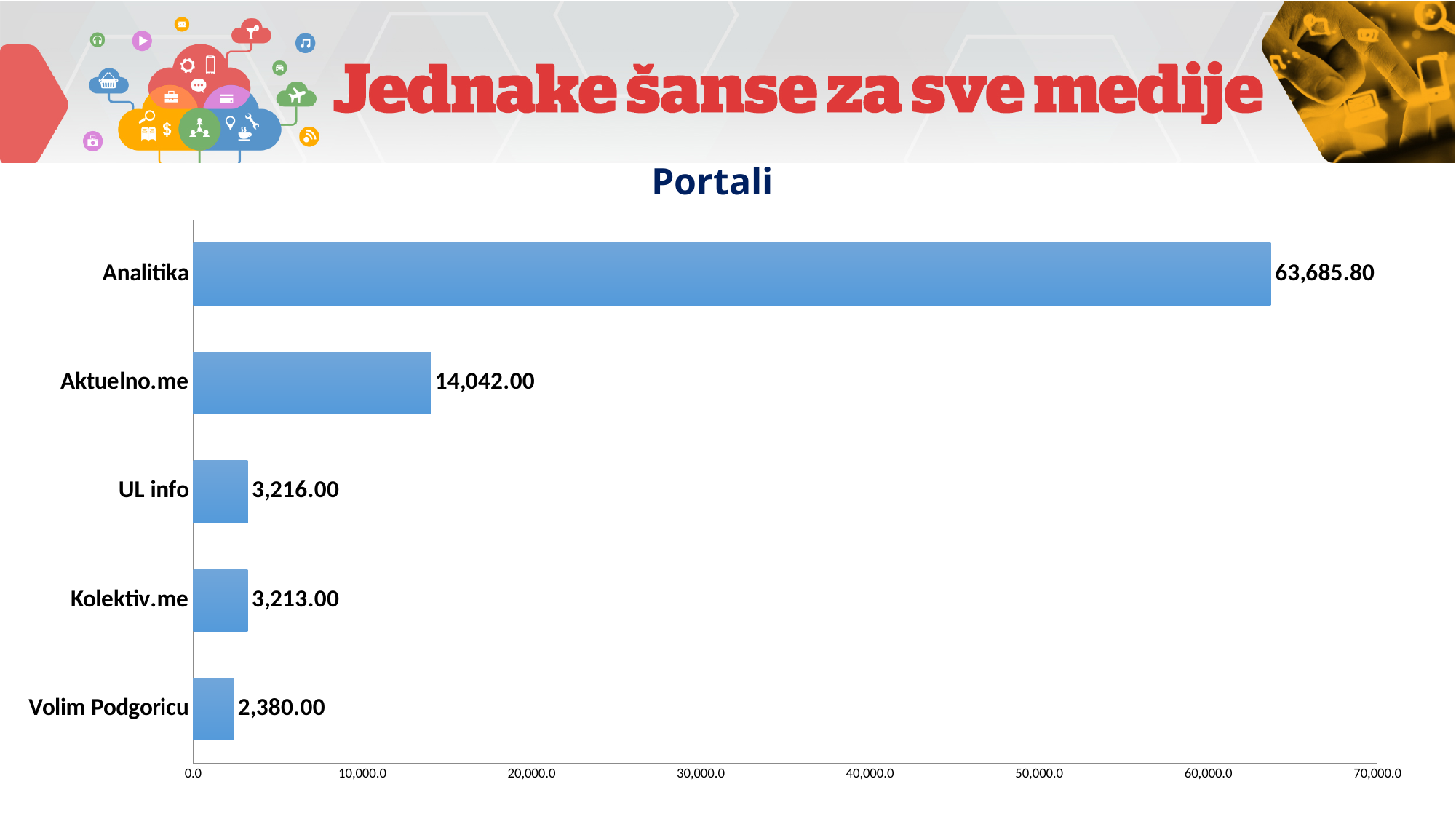
Which portal has the lowest value? Volim Podgoricu Which portal has the highest value? Analitika What is the difference between the values for UL info and Kolektiv.me? 3.00 Which is larger, the value for Aktuelno.me or the value for UL info? Aktuelno.me What is the value for Kolektiv.me? 3,213.00 What is the value for Volim Podgoricu? 2,380.00 What is the value for Analitika? 63,685.80 What is the difference between the values for Analitika and Aktuelno.me? 49,643.80 What kind of chart is shown on the slide? Bar chart What is the title of the chart? Portali What is the value for Aktuelno.me? 14,042.00 How many portals are shown in the chart? 5